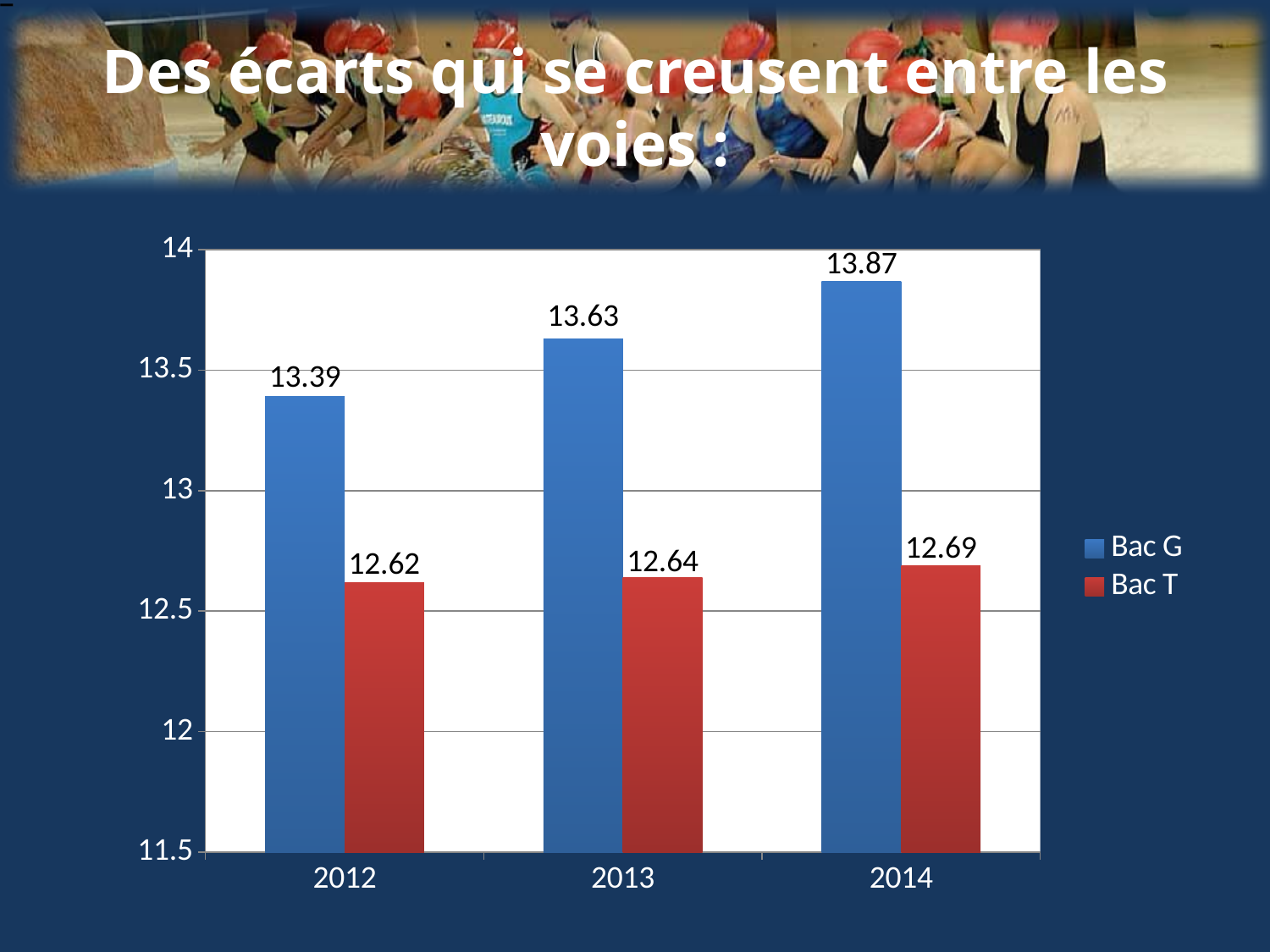
What is the difference between Bac G and Bac T in 2014? 1.18 What is the difference between the Bac G values for 2013 and 2012? 0.24 What is the value for Bac G in 2012? 13.39 How many years are shown on the x axis? 3 What is the value for Bac T in 2014? 12.69 Do the Bac G values rise or fall from 2012 to 2014? Rise In which year is the Bac G value highest? 2014 What is the value for Bac T in 2013? 12.64 Which is larger in 2013, Bac G or Bac T? Bac G What kind of chart is shown on the slide? Bar chart In which year is the Bac T value lowest? 2012 How many series does the legend list? 2